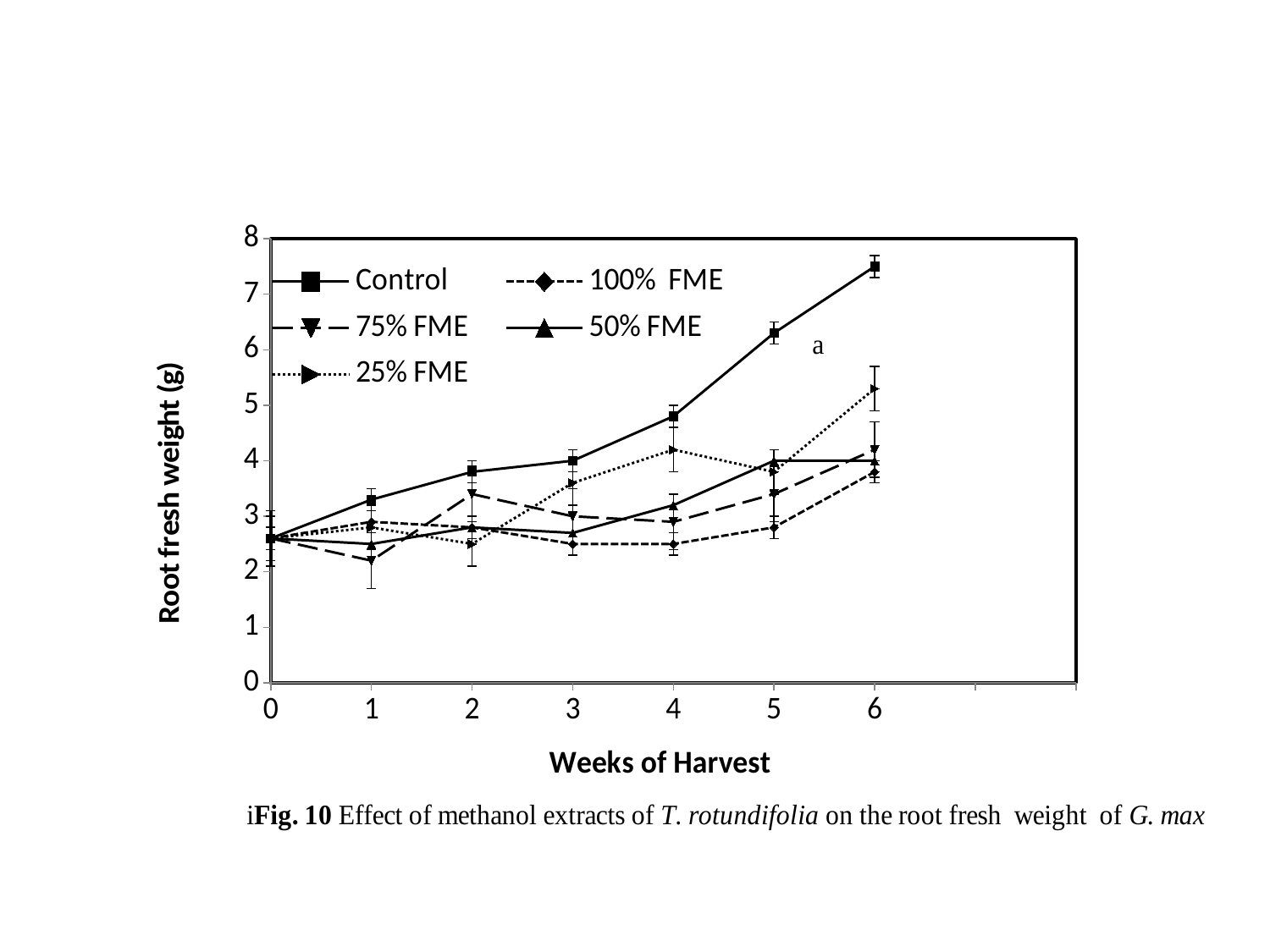
How many series does the legend list? 5 What kind of chart is shown on the slide? line chart What is the title of the y axis? Root fresh weight (g) Is the value for 100% FME at week 4 greater or less than 3? less Which series has the lowest root fresh weight at week 1? 75% FME Is the value for Control at week 6 greater or less than 7? greater Does the Control series rise or fall from week 0 to week 6? rise Which series has the highest root fresh weight at week 6? Control Is the value for Control at week 5 greater or less than 5? greater At week 6, which is larger: the value for Control or the value for 100% FME? Control At week 6, which is larger: the value for 25% FME or the value for 75% FME? 25% FME How many weeks of harvest are plotted along the x axis? 7